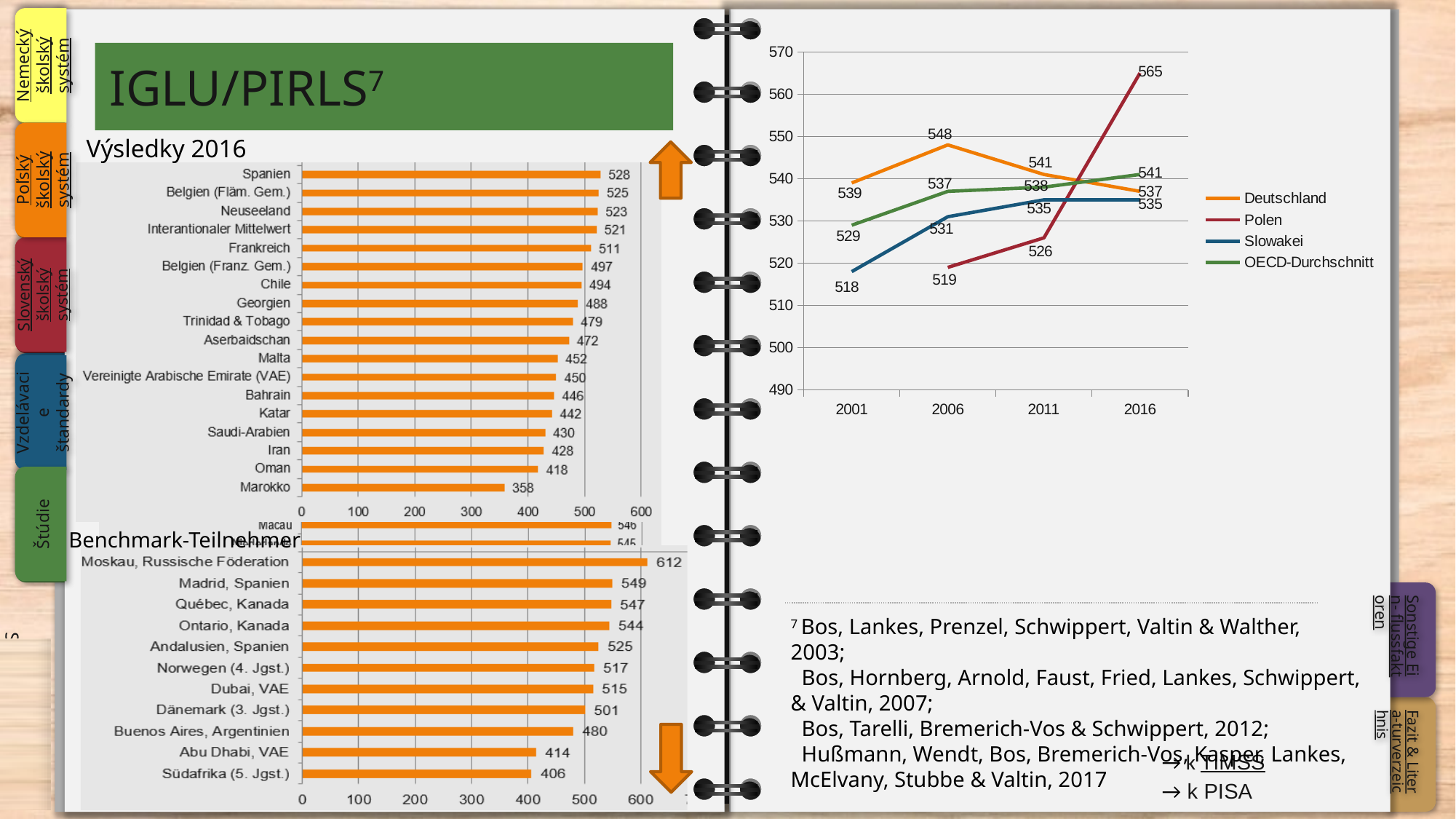
In the line chart on the right, how many series does the legend list? 4 In the 'Benchmark-Teilnehmer' bar chart, which is larger: Madrid, Spanien or Québec, Kanada? Madrid, Spanien In the line chart on the right, does the Polen series rise or fall from 2006 to 2016? rise In the line chart on the right, which colour is used for the Deutschland series? Orange In the line chart on the right, what is the value for Polen in 2016? 565 In the 'Výsledky 2016' bar chart, what is the value for Marokko? 358 In the line chart on the right, what is the value for OECD-Durchschnitt in 2001? 529 In the line chart on the right, what is the difference between Deutschland's value in 2006 and its value in 2016? 11 In the line chart on the right, which series has the highest value in 2016? Polen In the line chart on the right, what is the value for Deutschland in 2006? 548 In the 'Výsledky 2016' bar chart, which category has the highest value? Spanien In the 'Benchmark-Teilnehmer' bar chart, what is the value for Moskau, Russische Föderation? 612